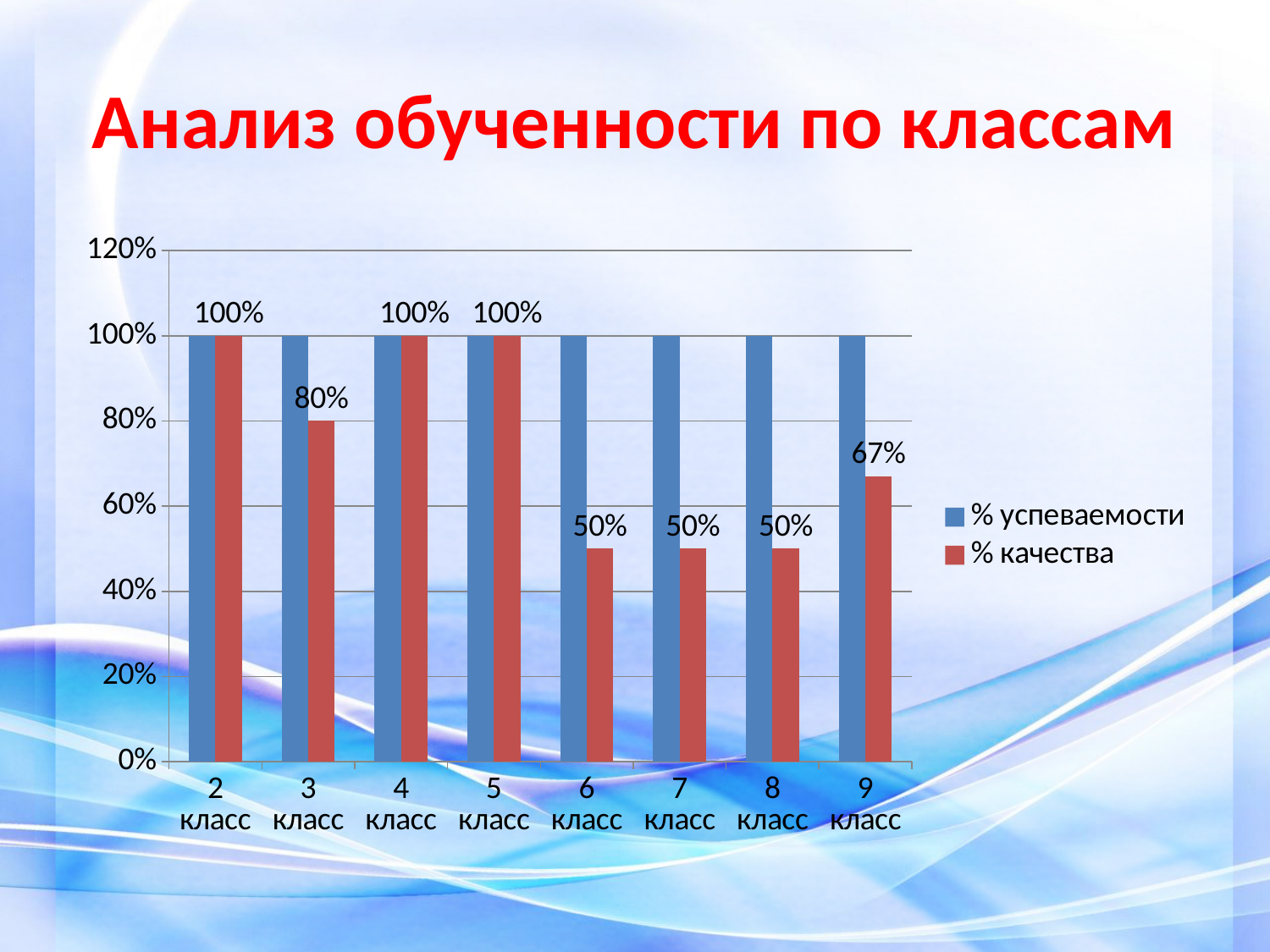
What is the difference between the % качества values for 3 класс and 9 класс? 13% What type of chart is shown on the slide? bar chart What is the % качества value for 3 класс? 80% Which class has the lowest % качества value among 2, 3, 4, 5 and 9 класс? 9 класс Which is larger: the % качества value for 3 класс or for 8 класс? 3 класс What is the % качества value for 6 класс? 50% Is the % качества value for 9 класс greater or less than 60%? greater How many classes (categories) are shown on the x axis? 8 What is the % качества value for 9 класс? 67% What is the % успеваемости value for 7 класс? 100% What is the title of the slide? Анализ обученности по классам How many series does the legend list? 2